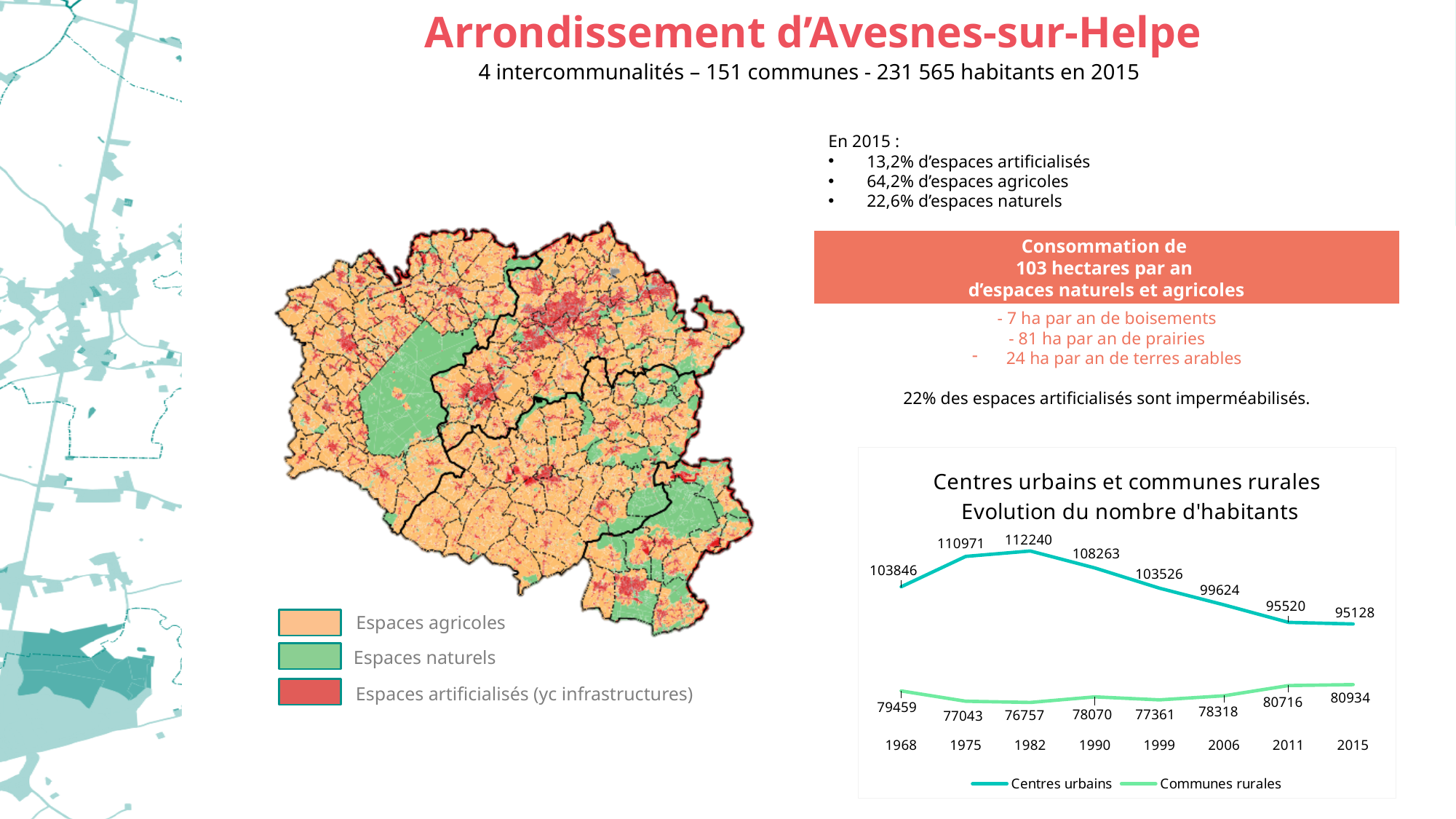
What type of chart is 'Centres urbains et communes rurales - Evolution du nombre d'habitants'? Line chart What are the two series named in the legend of the line chart? Centres urbains and Communes rurales In the line chart, what is the value for Centres urbains in 1968? 103846 How many series does the legend of the line chart list? 2 In the line chart, what is the value for Centres urbains in 1982? 112240 In the line chart, what is the difference between the Centres urbains values in 1968 and 2015? 8718 In the line chart, in which year is the Communes rurales value lowest? 1982 In the line chart, in which year is the Centres urbains value highest? 1982 In the line chart, does the Centres urbains series rise or fall between 1982 and 2015? Fall In the line chart, which is larger in 2015: Centres urbains or Communes rurales? Centres urbains How many years are plotted on the x axis of the line chart? 8 In the line chart, what is the value for Communes rurales in 2015? 80934